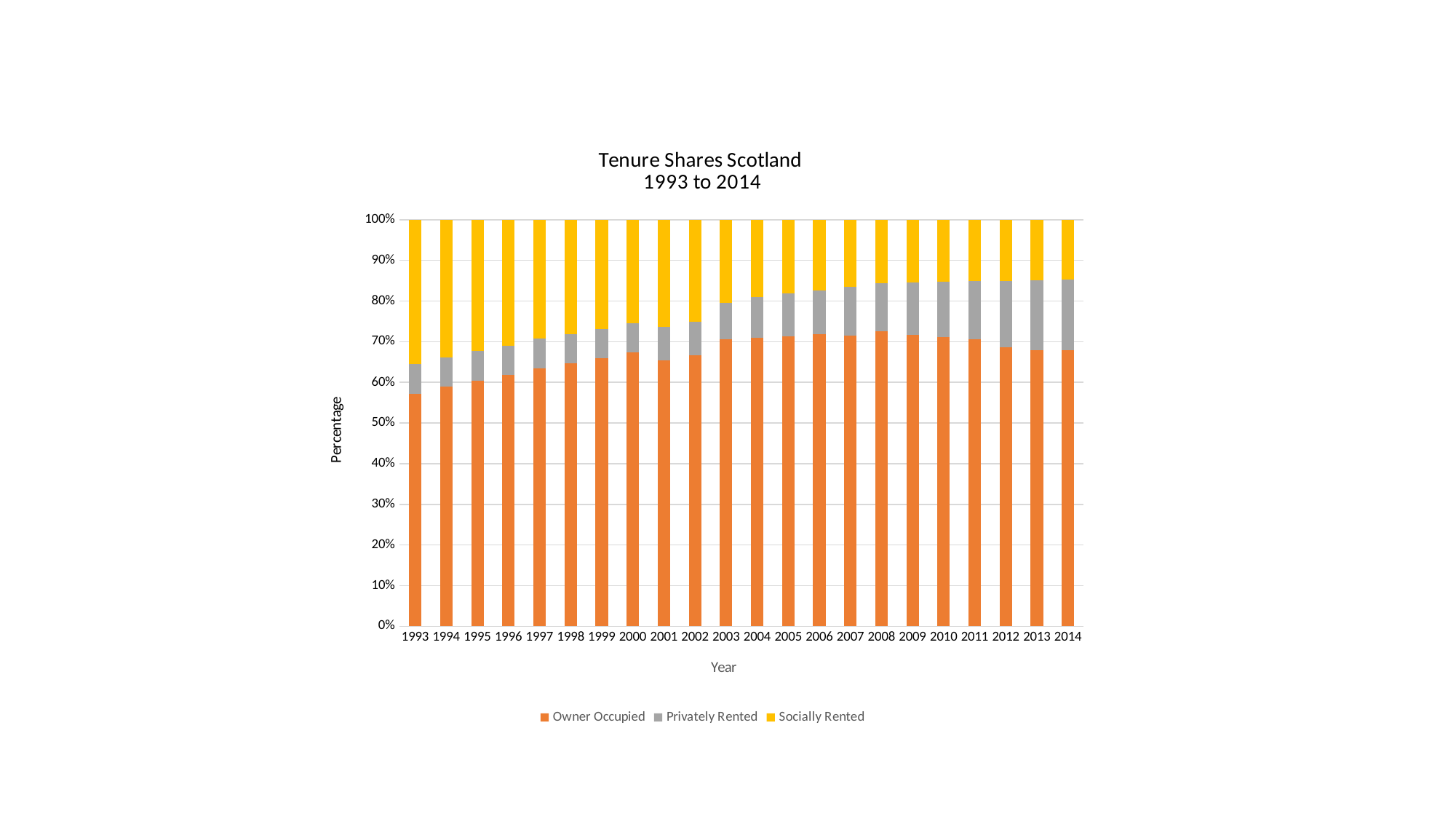
Is the Owner Occupied share in 2014 greater or less than 70%? less What is the title of the chart? Tenure Shares Scotland 1993 to 2014 Which year has the larger Owner Occupied share, 1993 or 2014? 2014 In which year is the Owner Occupied share lowest? 1993 How many series does the legend list? 3 In which year is the Socially Rented share largest? 1993 What kind of chart is shown on the slide? Stacked bar chart Is the Owner Occupied share in 2008 greater or less than 70%? greater Is the Owner Occupied share in 1993 greater or less than 60%? less Which series is shown in yellow? Socially Rented Does the Socially Rented share generally rise or fall from 1993 to 2014? fall How many years are shown along the x axis? 22